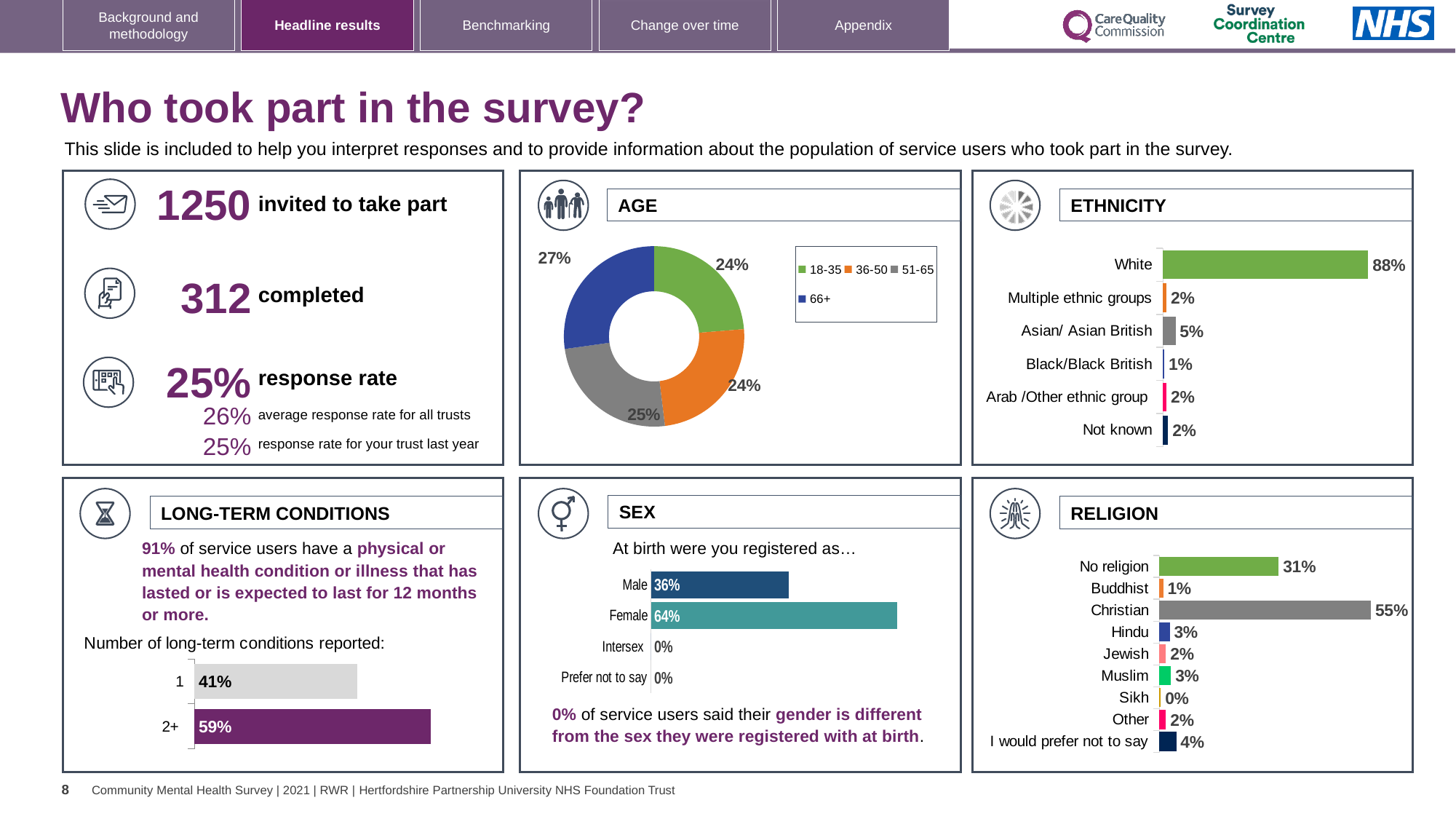
In the AGE chart, what share of respondents are aged 66+? 27% In the ETHNICITY chart, what is the difference between White and Asian/ Asian British? 83% In the ETHNICITY chart, what is the value for Asian/ Asian British? 5% In the LONG-TERM CONDITIONS chart, what percentage reported 2+ conditions? 59% In the RELIGION chart, what is the value for I would prefer not to say? 4% In the AGE chart, how many entries does the legend list? 4 In the ETHNICITY chart, how many categories are shown? 6 What kind of chart is the AGE chart? Donut (pie) chart In the SEX chart, what is the difference between Female and Male? 28% In the ETHNICITY chart, which category has the highest value? White In the SEX chart, which is larger, Male or Female? Female In the RELIGION chart, which category has the highest value? Christian